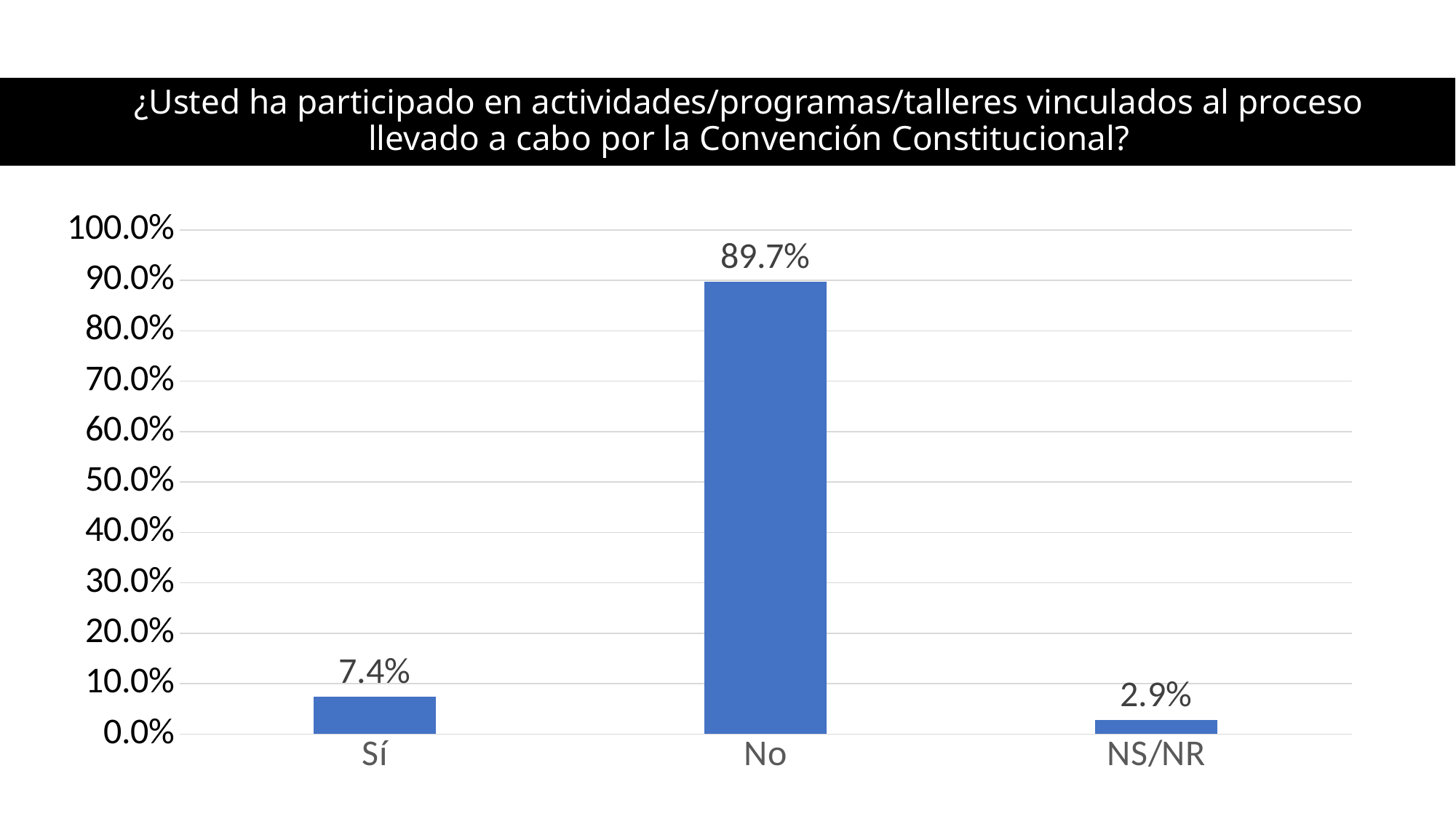
Is the value for No greater or less than 80.0%? greater Which is larger, the value for Sí or the value for NS/NR? Sí What is the difference between the values for No and Sí? 82.3% What kind of chart is shown on the slide? bar chart What is the value for No? 89.7% What is the highest value shown on the y axis? 100.0% How many categories are shown on the x axis? 3 What is the value for NS/NR? 2.9% What is the value for Sí? 7.4% Which category has the lowest value? NS/NR What is the difference between the values for Sí and NS/NR? 4.5% Which category has the highest value? No